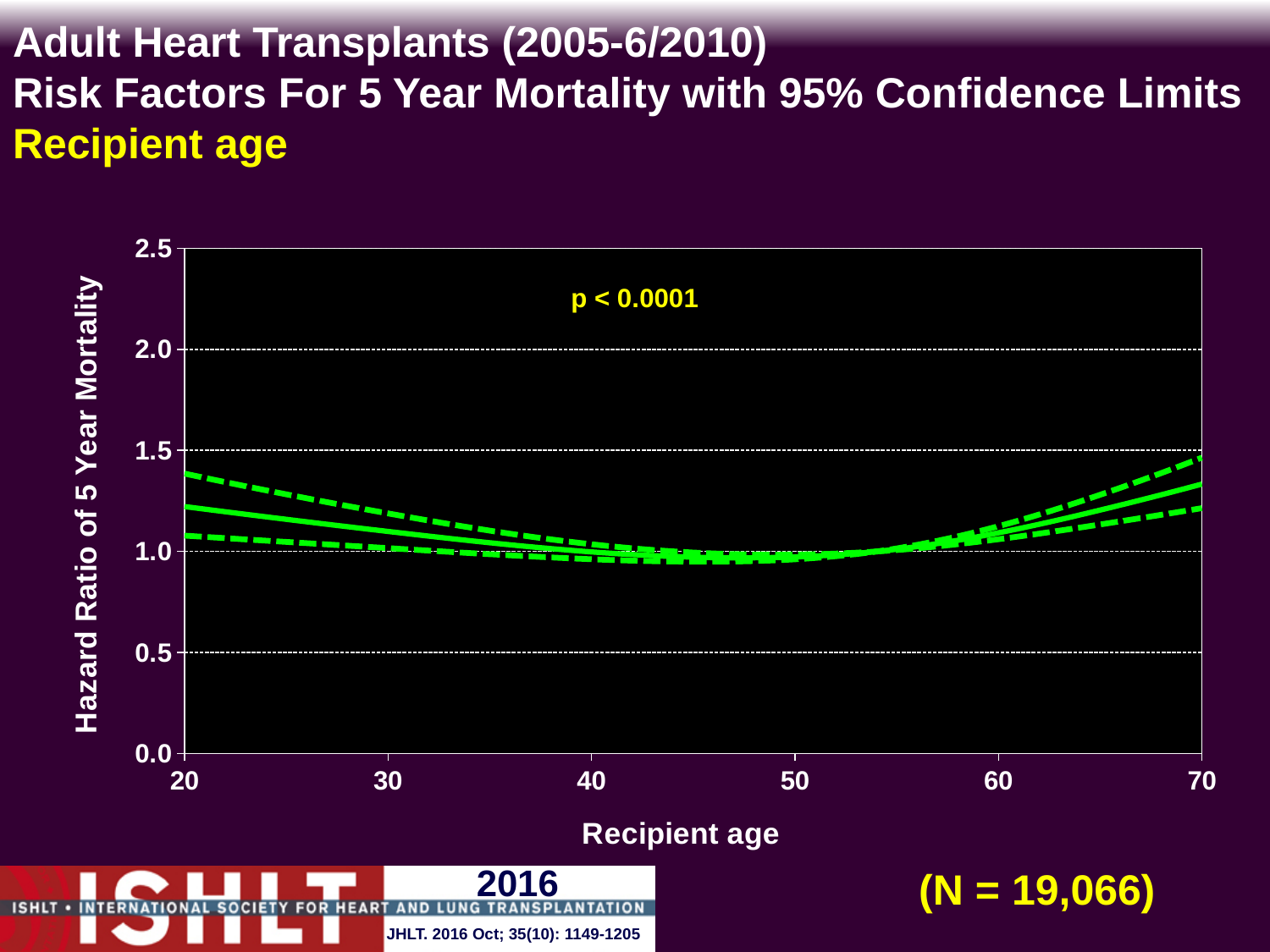
Which has the larger hazard ratio of 5 year mortality: a recipient age of 20 or a recipient age of 50? 20 Is the hazard ratio of 5 year mortality for a recipient age of 20 greater or less than 1.0? greater Is the hazard ratio of 5 year mortality for a recipient age of 20 greater or less than 1.5? less What kind of chart is shown on the slide? line chart What is the label of the x axis? Recipient age What p-value is printed on the chart? p < 0.0001 Is the hazard ratio of 5 year mortality for a recipient age of 70 greater or less than 1.0? greater Does the hazard ratio rise or fall as recipient age increases from 50 to 70? rise Which has the larger hazard ratio of 5 year mortality: a recipient age of 50 or a recipient age of 70? 70 Does the hazard ratio rise or fall as recipient age increases from 20 to 50? fall How many lines are plotted on the chart? 3